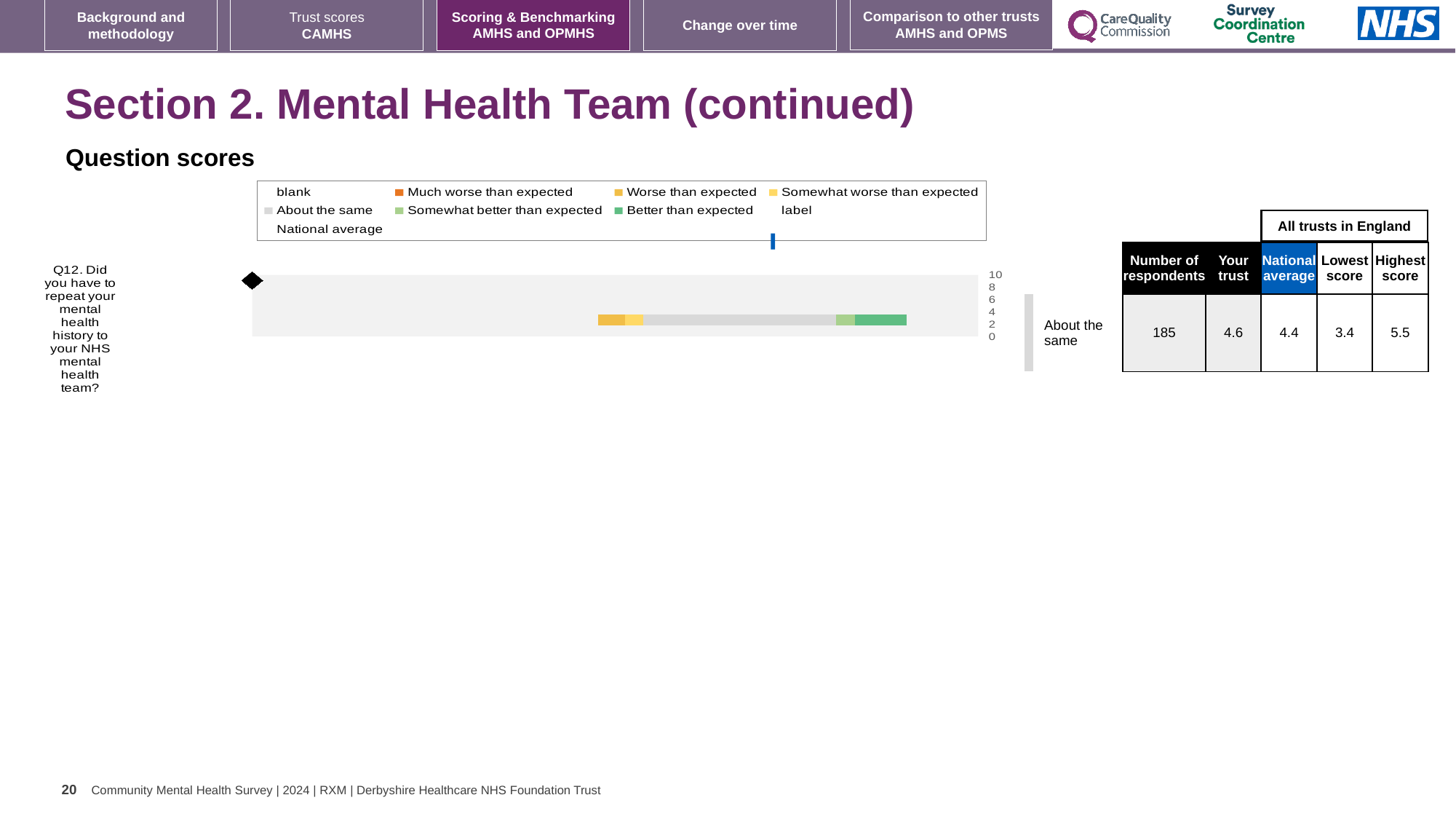
How many survey questions are plotted on the chart? 1 What kind of chart is used to show the Q12 question score? bar chart Which is larger for Q12, the 'Your trust' score or the national average? Your trust What is the 'Your trust' score for Q12? 4.6 Which question is plotted on the chart? Q12. Did you have to repeat your mental health history to your NHS mental health team? What colour represents 'Better than expected' in the chart legend? green How many respondents answered Q12? 185 What is the lowest score among all trusts in England for Q12? 3.4 What is the national average score for Q12? 4.4 What is the difference between the highest and lowest scores for Q12 across all trusts in England? 2.1 What is the highest score among all trusts in England for Q12? 5.5 What benchmark category is shown for Q12 next to the chart? About the same